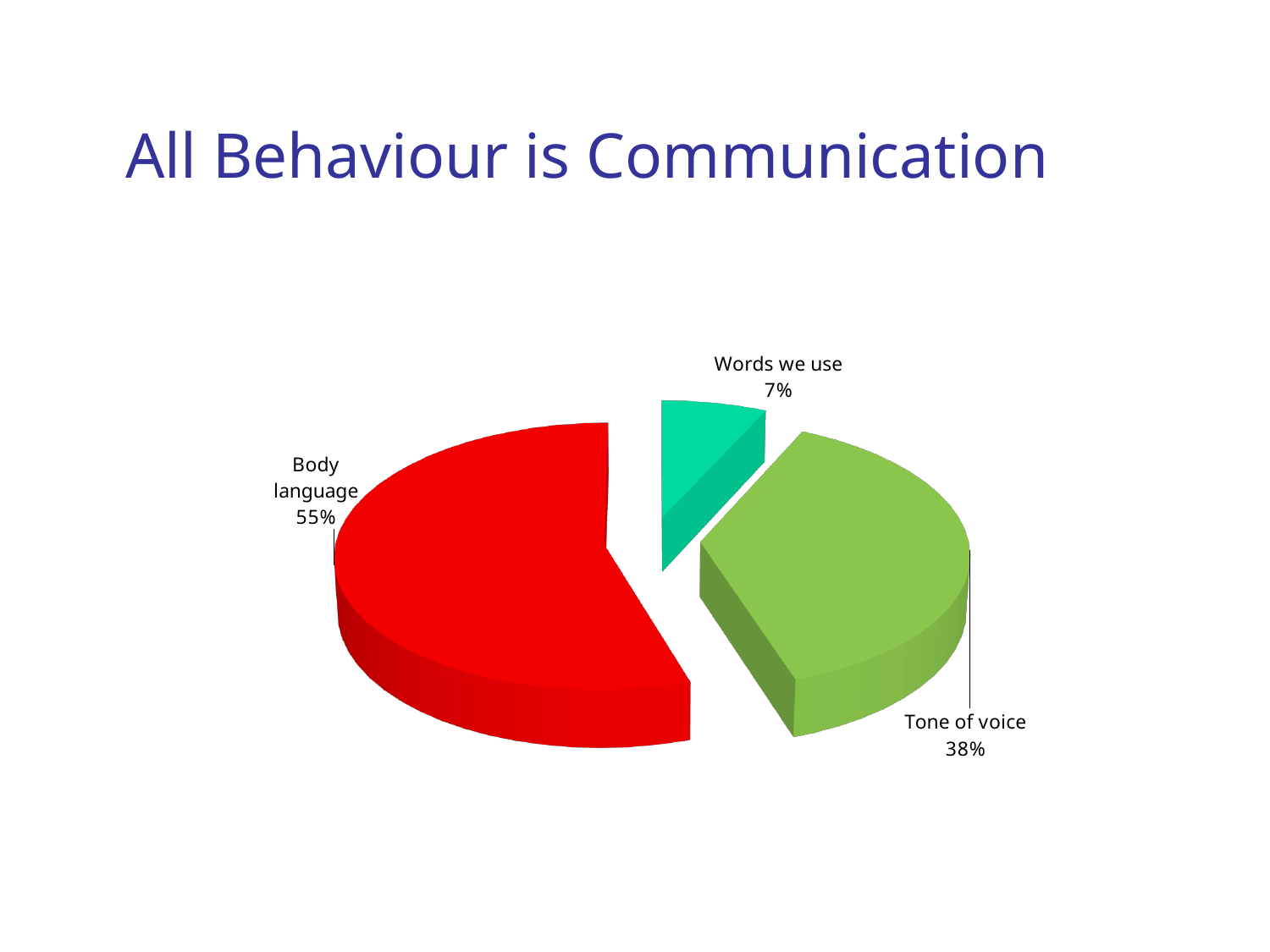
How many slices does the pie chart have? 3 What kind of chart is shown on the slide? pie chart What is the title of the slide containing the pie chart? All Behaviour is Communication Which slice of the pie is the largest? Body language What share of the pie does Words we use take? 7% Which slice of the pie is the smallest? Words we use What is the difference in percentage points between Body language and Tone of voice? 17 Which is larger, Tone of voice or Words we use? Tone of voice What colour is the Body language slice? red What share of the pie does Tone of voice take? 38% What share of the pie does Body language take? 55% What is the difference in percentage points between Tone of voice and Words we use? 31